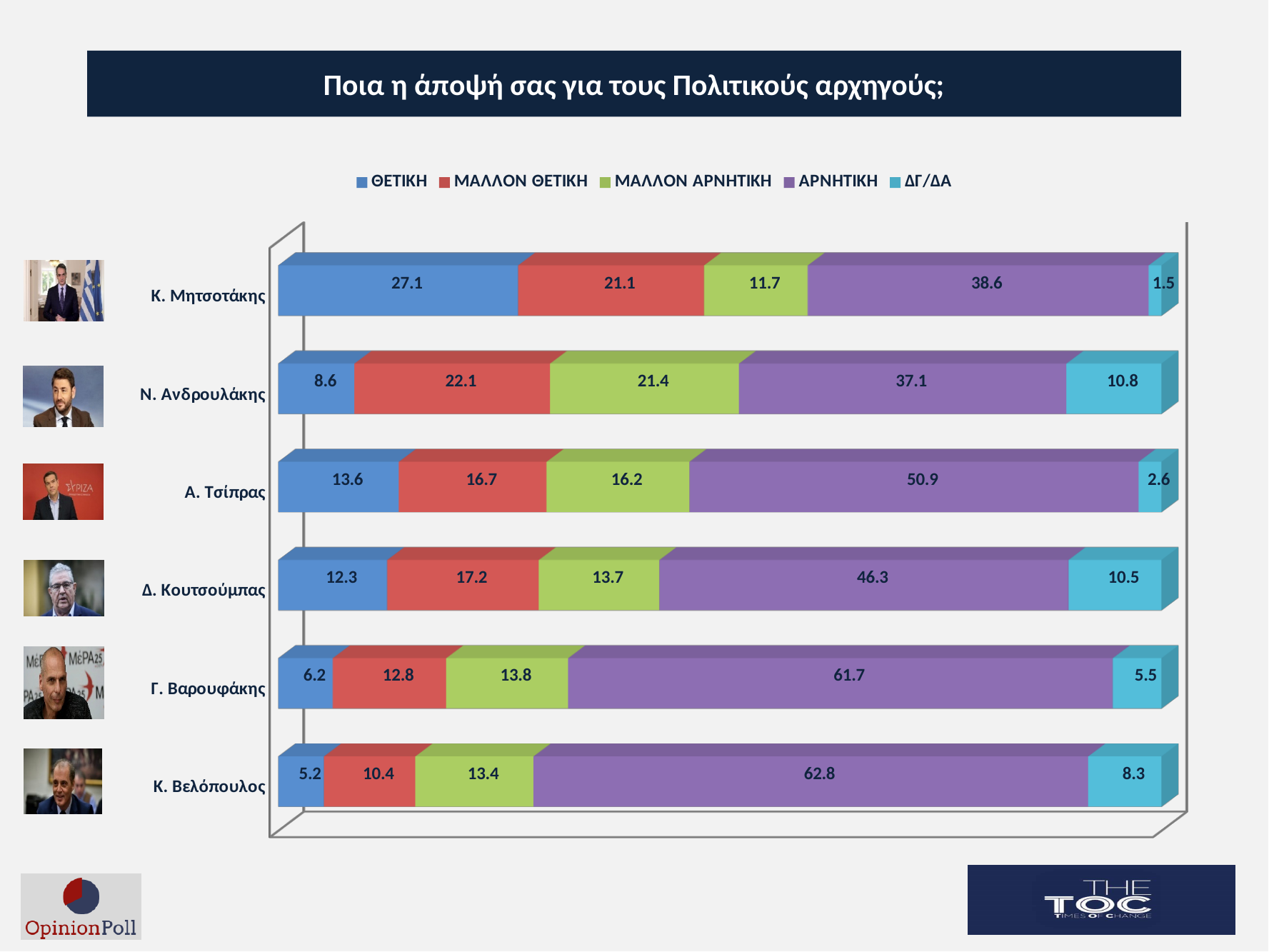
What is the title of the chart? Ποια η άποψή σας για τους Πολιτικούς αρχηγούς; How many series does the legend list? 5 Which is larger: the ΜΑΛΛΟΝ ΘΕΤΙΚΗ value for Ν. Ανδρουλάκης or for Δ. Κουτσούμπας? Ν. Ανδρουλάκης How many politicians are shown in the chart? 6 What is the ΘΕΤΙΚΗ value for Κ. Μητσοτάκης? 27.1 What is the ΑΡΝΗΤΙΚΗ value for Α. Τσίπρας? 50.9 Which politician has the highest ΘΕΤΙΚΗ value? Κ. Μητσοτάκης Which politician has the highest ΑΡΝΗΤΙΚΗ value? Κ. Βελόπουλος What is the ΔΓ/ΔΑ value for Ν. Ανδρουλάκης? 10.8 What is the difference between the ΑΡΝΗΤΙΚΗ and ΘΕΤΙΚΗ values for Κ. Μητσοτάκης? 11.5 Which politician has the lowest ΘΕΤΙΚΗ value? Κ. Βελόπουλος What kind of chart is shown on the slide? Stacked bar chart